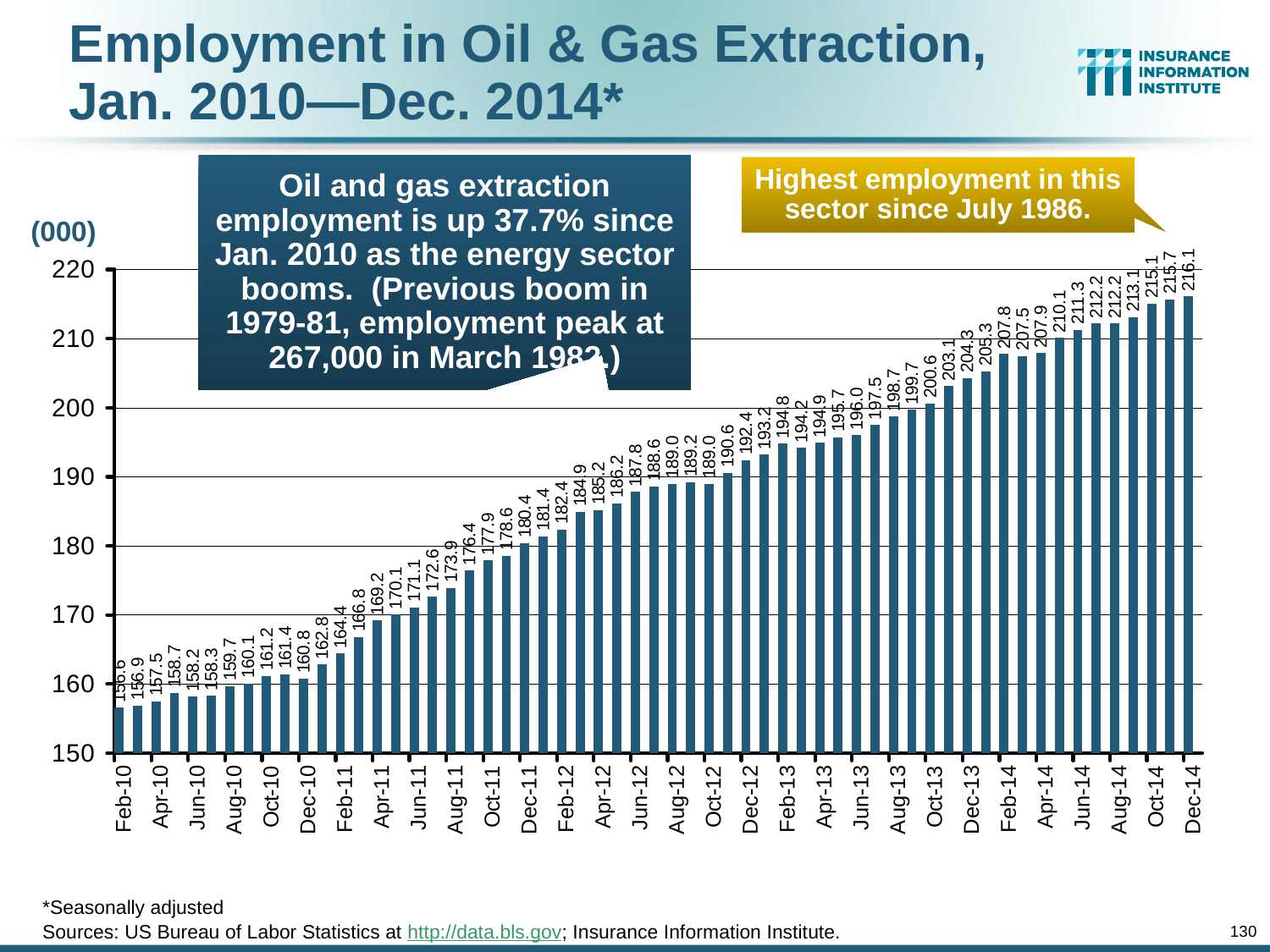
What is the employment value for Dec-14, the last bar on the chart? 216.1 Which month has the highest employment value on the chart? Dec-14 Which month has the lowest employment value on the chart? Feb-10 What unit is indicated for the y-axis values? (000) Is the value for Feb-10 greater or less than 160? less Do the values generally rise or fall from Feb-10 to Dec-14? Rise What is the employment value for Feb-10, the first bar on the chart? 156.6 What type of chart is shown on the slide? Bar chart According to the callout, since when has employment in this sector been at its highest? July 1986 Is the value for Dec-14 greater or less than 210? greater Which is larger, the value for Dec-14 or the value for Feb-10? Dec-14 What is the difference between the Dec-14 value (216.1) and the Feb-10 value (156.6)? 59.5